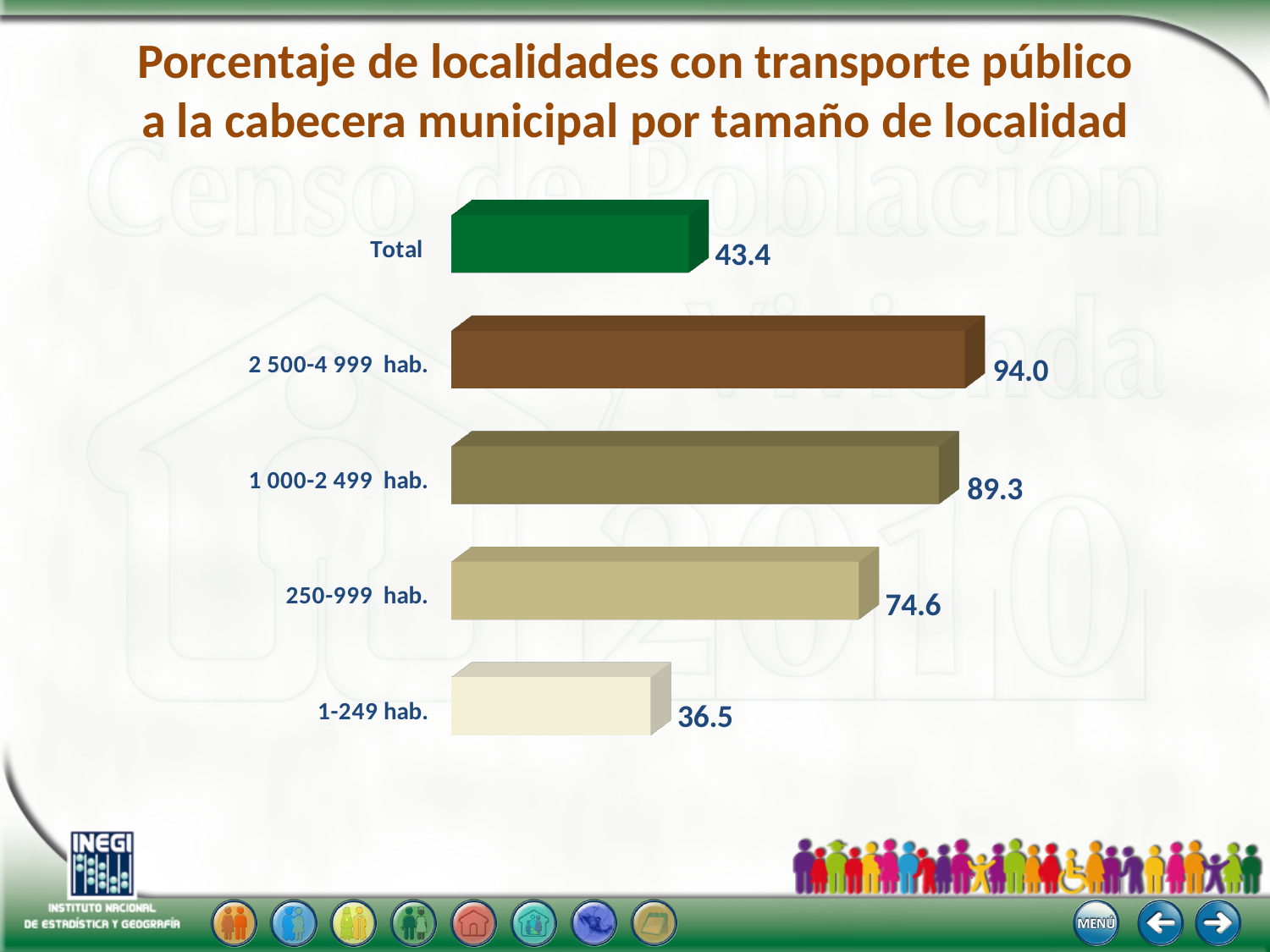
What is the value for 1 000-2 499 hab.? 89.3 Which category has the highest value? 2 500-4 999 hab. What is the difference between the values for 1 000-2 499 hab. and 250-999 hab.? 14.7 What is the value for 1-249 hab.? 36.5 What kind of chart is shown on the slide? bar chart What is the difference between the values for 2 500-4 999 hab. and 1-249 hab.? 57.5 How many categories are shown in the chart? 5 Which is larger, the value for Total or the value for 1-249 hab.? Total What is the value for 2 500-4 999 hab.? 94.0 What is the value for 250-999 hab.? 74.6 What is the value for Total? 43.4 Which category has the lowest value? 1-249 hab.